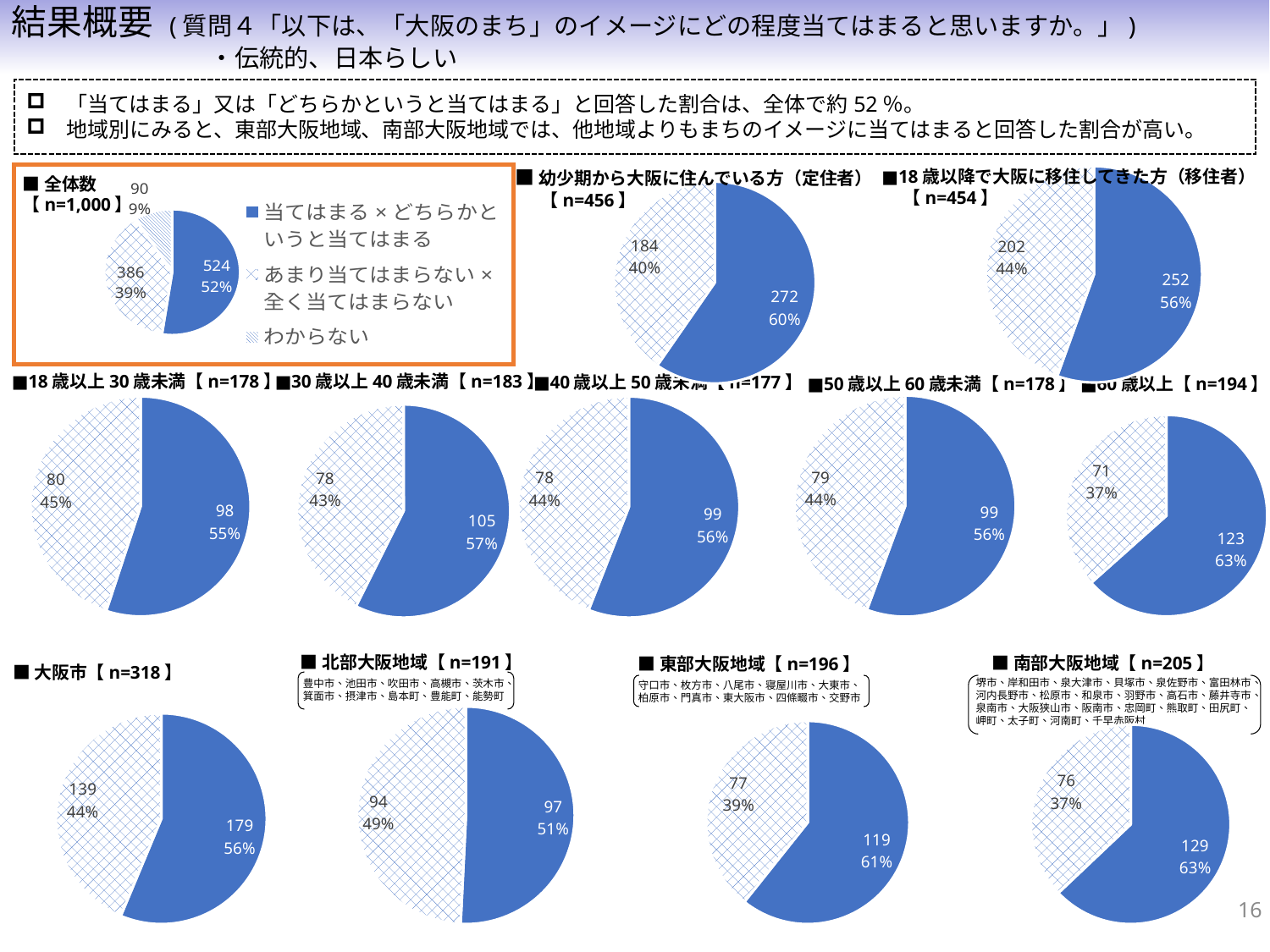
In the 18歳以降で大阪に移住してきた方（移住者）【n=454】 pie chart, what is the count shown for the hatched slice? 202 What type of chart is used for the 幼少期から大阪に住んでいる方（定住者）【n=456】 data? Pie chart Among the five age-group pie charts (18歳以上30歳未満 through 60歳以上), which group has the highest percentage for the blue slice? 60歳以上 In the 幼少期から大阪に住んでいる方（定住者）【n=456】 pie chart, what percentage is shown for the blue slice? 60% Which has a larger blue-slice percentage: the 東部大阪地域【n=196】 pie chart or the 北部大阪地域【n=191】 pie chart? 東部大阪地域 In the 30歳以上40歳未満【n=183】 pie chart, what is the difference between the two slice counts (105 and 78)? 27 In the 全体数【n=1,000】 pie chart, what is the count for 「当てはまる × どちらかというと当てはまる」? 524 In the 南部大阪地域【n=205】 pie chart, what is the count shown for the blue slice? 129 In the 全体数【n=1,000】 pie chart, what percentage share is shown for 「わからない」? 9% Among the four regional pie charts (大阪市, 北部大阪地域, 東部大阪地域, 南部大阪地域), which has the lowest blue-slice percentage? 北部大阪地域 In the 大阪市【n=318】 pie chart, what is the total of the two slice counts (179 and 139)? 318 How many entries does the legend of the 全体数【n=1,000】 pie chart list? 3